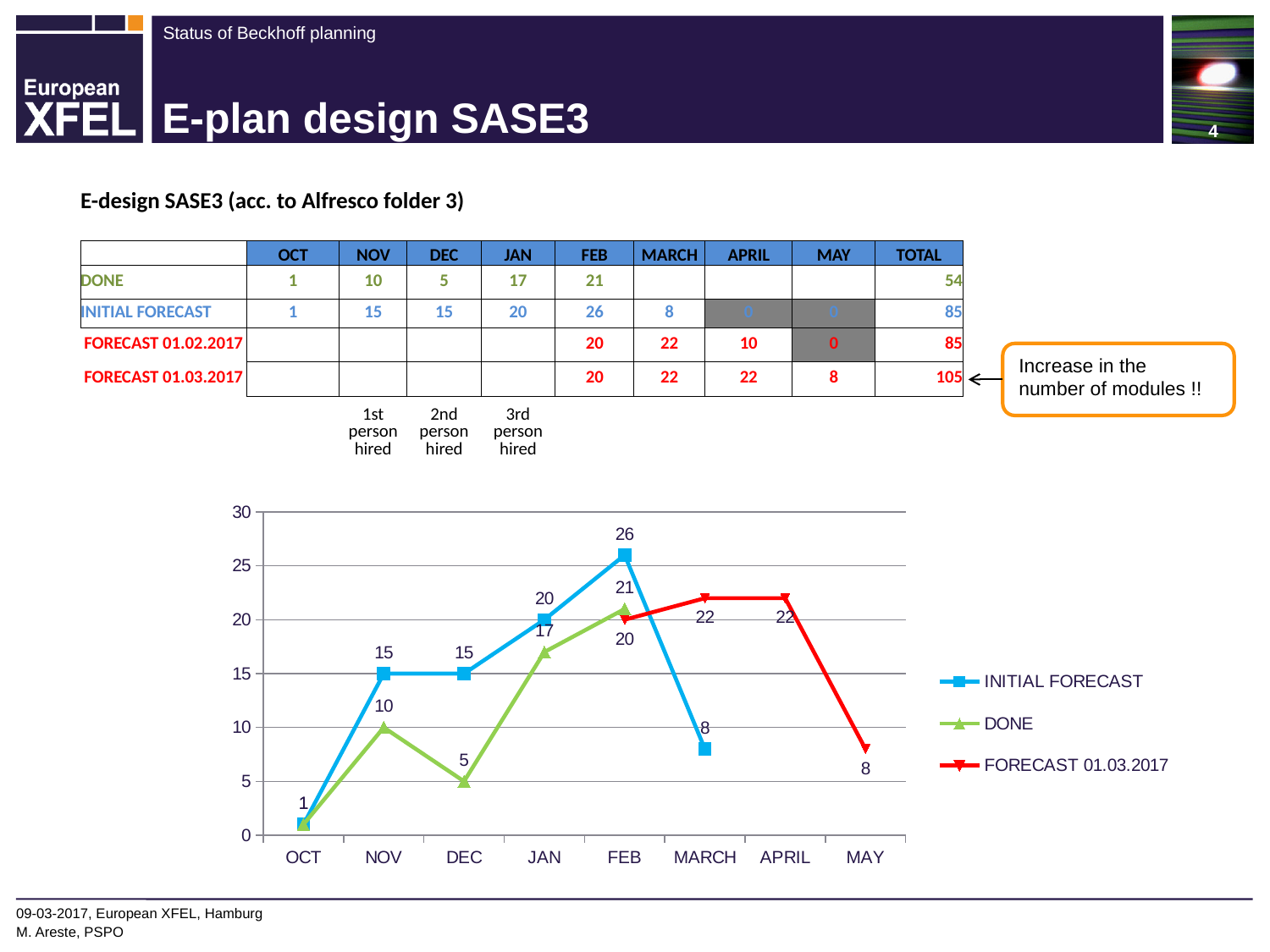
What is the FORECAST 01.03.2017 value for MAY in the chart? 8 What is the difference between the INITIAL FORECAST and DONE values for NOV? 5 Which is larger in FEB: the INITIAL FORECAST value or the FORECAST 01.03.2017 value? INITIAL FORECAST What type of chart is shown on the slide? line chart How many categories are shown on the x axis of the chart? 8 How many series does the chart legend list? 3 What is the DONE value for JAN in the chart? 17 Does the DONE series rise or fall from DEC to JAN? rise Which colour is used for the FORECAST 01.03.2017 series in the chart? red In which month is the DONE series at its lowest value? OCT In which month does the INITIAL FORECAST series reach its highest value? FEB What is the INITIAL FORECAST value for FEB in the chart? 26